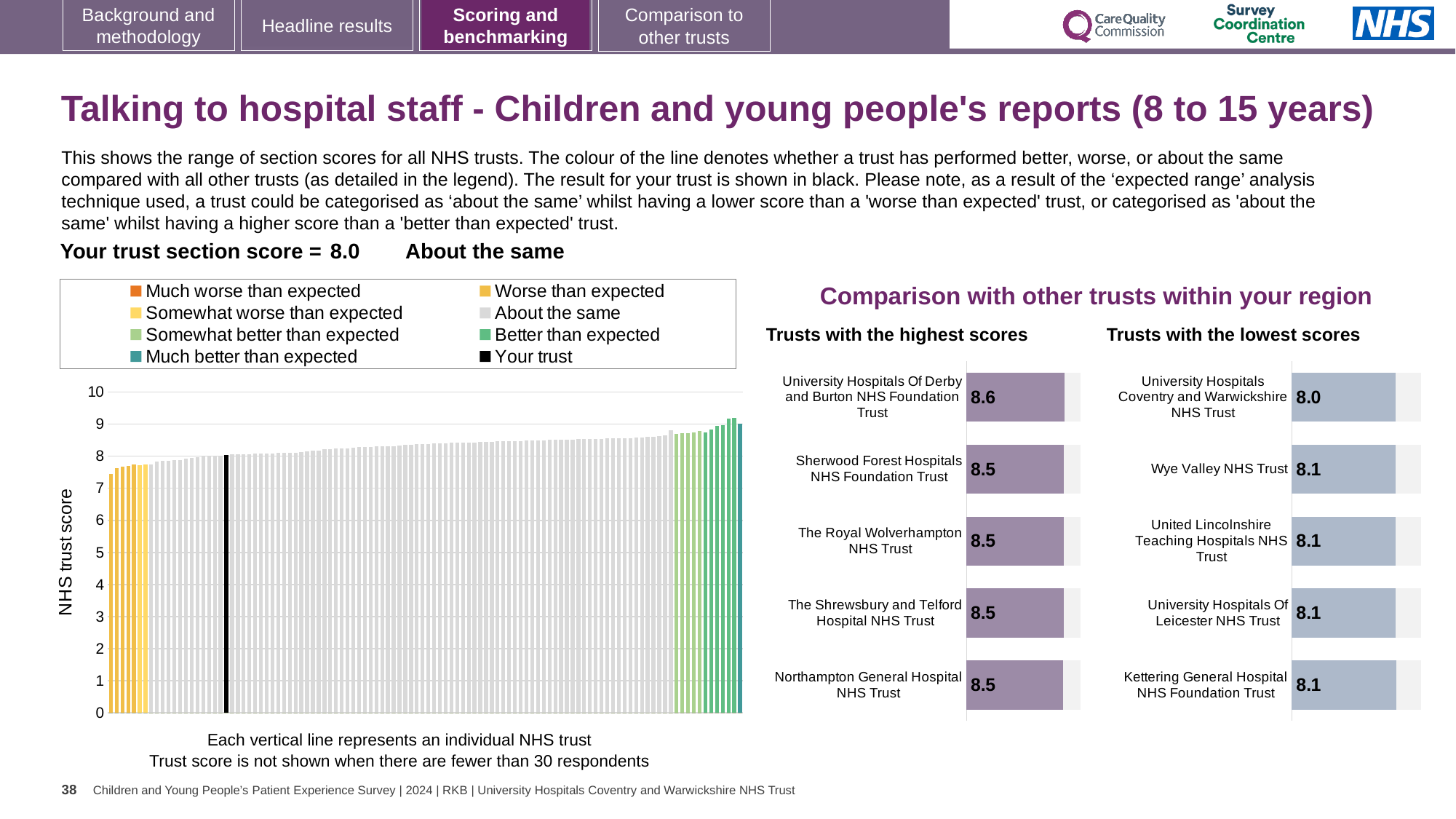
In the 'Trusts with the highest scores' chart, how many trusts are shown? 5 In the 'Trusts with the lowest scores' chart, what is the score for Kettering General Hospital NHS Foundation Trust? 8.1 In the 'Trusts with the lowest scores' chart, which trust has the lowest score? University Hospitals Coventry and Warwickshire NHS Trust In the 'Trusts with the lowest scores' chart, what is the score for University Hospitals Coventry and Warwickshire NHS Trust? 8.0 In the 'Trusts with the highest scores' chart, what is the score for University Hospitals Of Derby and Burton NHS Foundation Trust? 8.6 In the 'Trusts with the highest scores' chart, which trust has the highest score? University Hospitals Of Derby and Burton NHS Foundation Trust In the 'Trusts with the highest scores' chart, what is the difference between the score for University Hospitals Of Derby and Burton NHS Foundation Trust and the score for Sherwood Forest Hospitals NHS Foundation Trust? 0.1 How many entries does the legend of the large 'NHS trust score' chart on the left list? 8 In the large 'NHS trust score' chart on the left, do the bar heights rise or fall from left to right? rise In the large 'NHS trust score' chart on the left, is the value of the black 'Your trust' bar greater or less than 5? greater What kind of chart is the large chart on the left with the y-axis labelled 'NHS trust score'? bar chart In the 'Trusts with the lowest scores' chart, which has the larger score: Wye Valley NHS Trust or University Hospitals Coventry and Warwickshire NHS Trust? Wye Valley NHS Trust